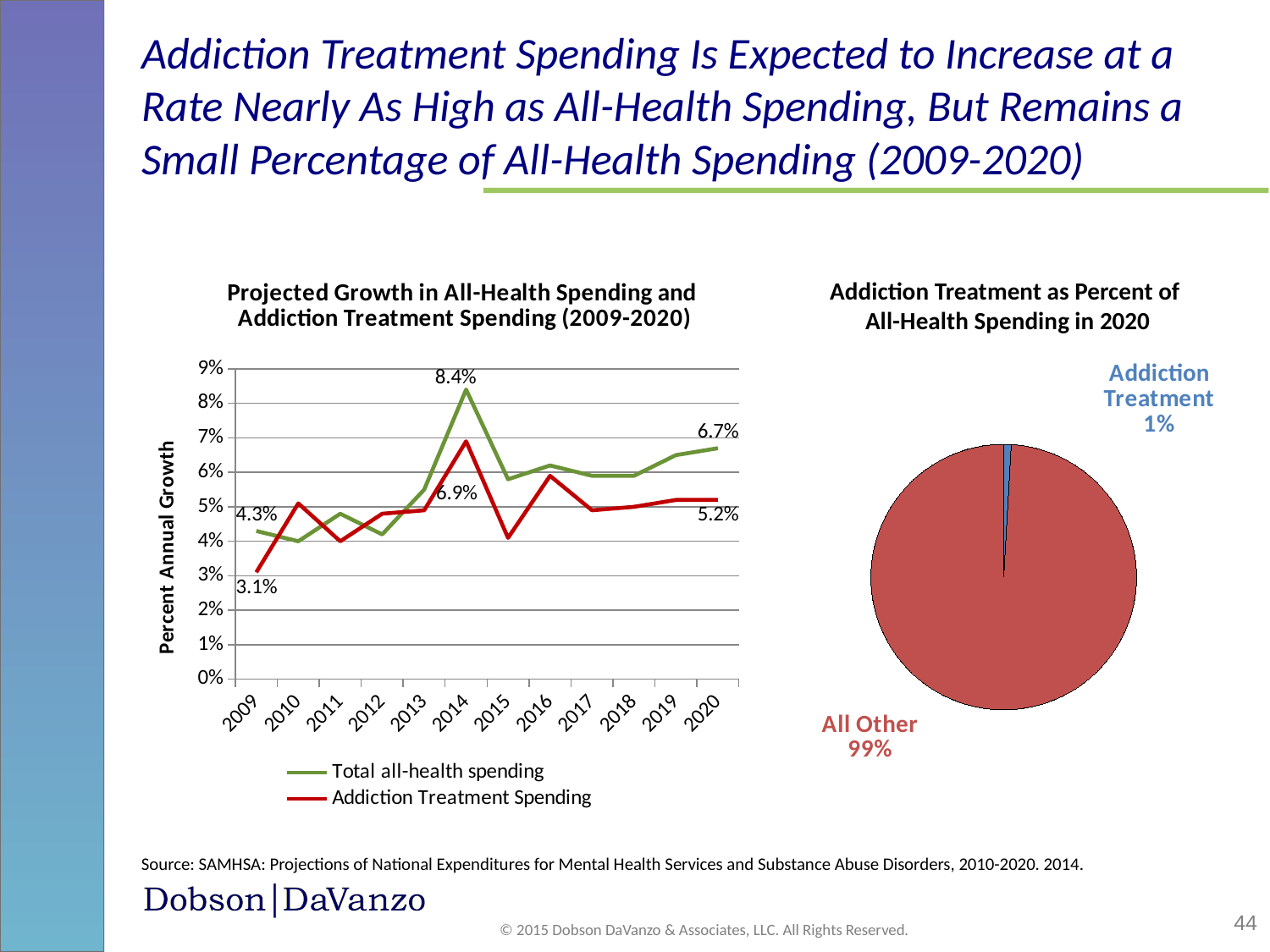
In the line chart on the left, what is the value for Total all-health spending in 2020? 6.7% In the pie chart 'Addiction Treatment as Percent of All-Health Spending in 2020', what share does Addiction Treatment have? 1% In the line chart on the left, which series has the larger value in 2009, Total all-health spending or Addiction Treatment Spending? Total all-health spending In the line chart on the left, in which year does Total all-health spending reach its highest value? 2014 How many years are shown on the x axis of the line chart on the left? 12 In the line chart on the left, is the value for Addiction Treatment Spending in 2015 greater or less than 5%? less In the line chart on the left, what is the difference between Total all-health spending and Addiction Treatment Spending in 2020? 1.5% In the line chart 'Projected Growth in All-Health Spending and Addiction Treatment Spending (2009-2020)', what is the value for Total all-health spending in 2014? 8.4% How many series does the legend of the line chart on the left list? 2 In the line chart on the left, what is the value for Addiction Treatment Spending in 2020? 5.2% In the line chart on the left, what is the value for Addiction Treatment Spending in 2009? 3.1% What kind of chart is 'Addiction Treatment as Percent of All-Health Spending in 2020'? Pie chart